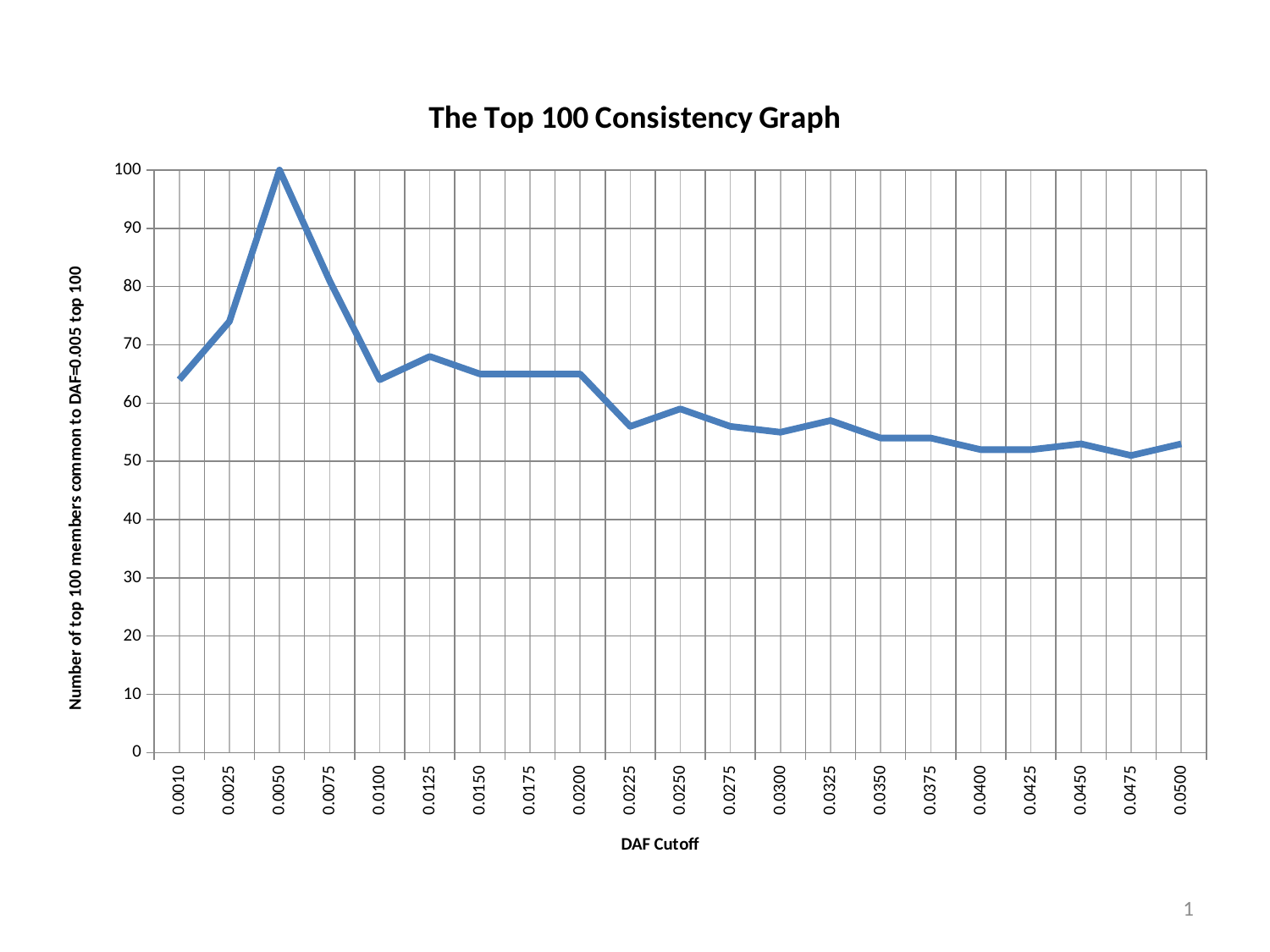
Which has a larger value, DAF Cutoff 0.0025 or DAF Cutoff 0.0100? 0.0025 Is the value for DAF Cutoff 0.0225 greater or less than 60? less From DAF Cutoff 0.0050 to 0.0500, do the values generally rise or fall? fall What is the label of the x axis? DAF Cutoff Is the value for DAF Cutoff 0.0075 greater or less than 90? less What is the title of the chart? The Top 100 Consistency Graph What is the value at DAF Cutoff 0.0050? 100 What kind of chart is shown on the slide? line chart How many DAF Cutoff points are plotted on the x axis? 21 Is the value for DAF Cutoff 0.0500 greater or less than 60? less At which DAF Cutoff is the number of common top 100 members highest? 0.0050